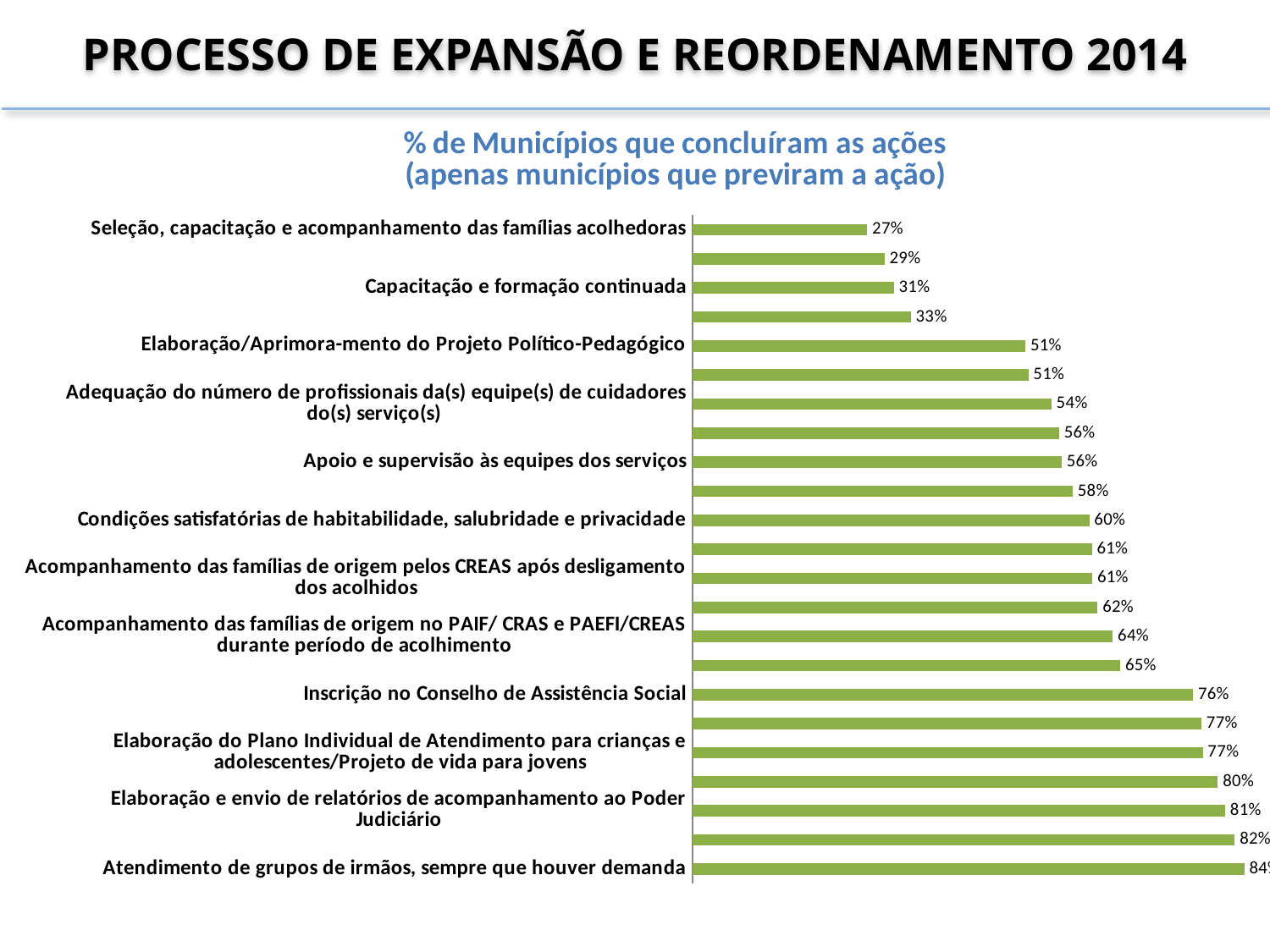
What type of chart is shown on the slide? Bar chart What is the value shown for "Capacitação e formação continuada"? 31% What is the difference between the values for "Inscrição no Conselho de Assistência Social" and "Capacitação e formação continuada"? 45% What is the value shown for "Inscrição no Conselho de Assistência Social"? 76% What percentage of municipalities concluded the action "Seleção, capacitação e acompanhamento das famílias acolhedoras"? 27% What is the value shown for "Elaboração e envio de relatórios de acompanhamento ao Poder Judiciário"? 81% Which has a higher value: "Apoio e supervisão às equipes dos serviços" or "Acompanhamento das famílias de origem no PAIF/ CRAS e PAEFI/CREAS durante período de acolhimento"? Acompanhamento das famílias de origem no PAIF/ CRAS e PAEFI/CREAS durante período de acolhimento What is the title of the chart? % de Municípios que concluíram as ações (apenas municípios que previram a ação) What is the value shown for "Condições satisfatórias de habitabilidade, salubridade e privacidade"? 60% How many bars are plotted in the chart? 23 Which labelled action has the highest percentage of municipalities that concluded it? Atendimento de grupos de irmãos, sempre que houver demanda Which labelled action has the lowest percentage of municipalities that concluded it? Seleção, capacitação e acompanhamento das famílias acolhedoras